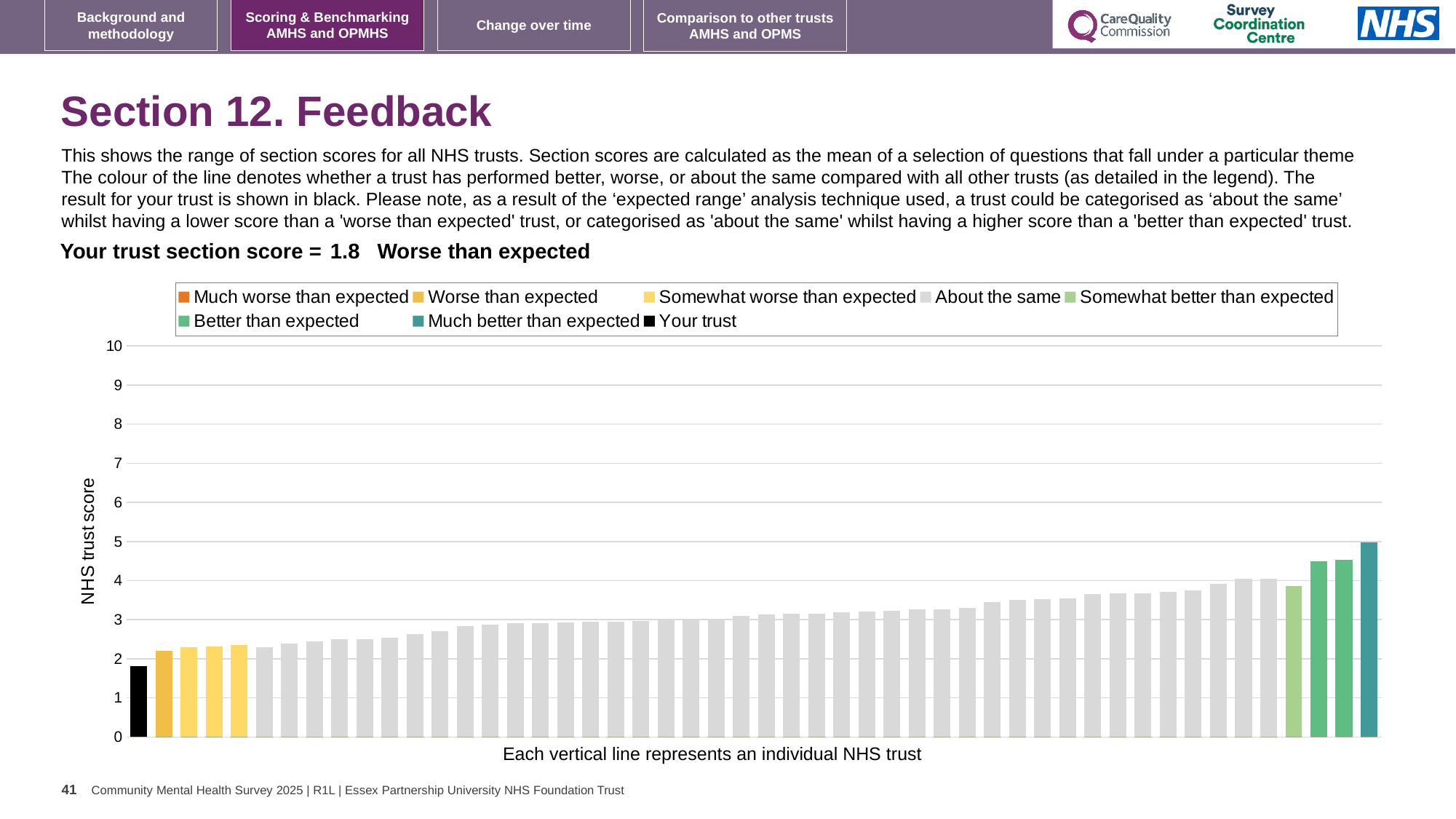
Is the value for your trust (the black bar) greater or less than 2? less How many entries does the chart legend list? 8 Do the bar values rise or fall from left to right along the x axis? rise What is the label on the y axis of the chart? NHS trust score Are the values for the 'Better than expected' (green) bars greater or less than 4? greater What is the highest value shown on the y axis? 10 What kind of chart is shown on the slide? bar chart What is the section score for your trust shown on the slide? 1.8 How many bars are coloured as 'Worse than expected' (yellow)? 1 Which legend category does the tallest bar in the chart belong to? Much better than expected Which legend category does the shortest bar in the chart belong to? Your trust Which category does your trust's section score fall into according to the slide? Worse than expected